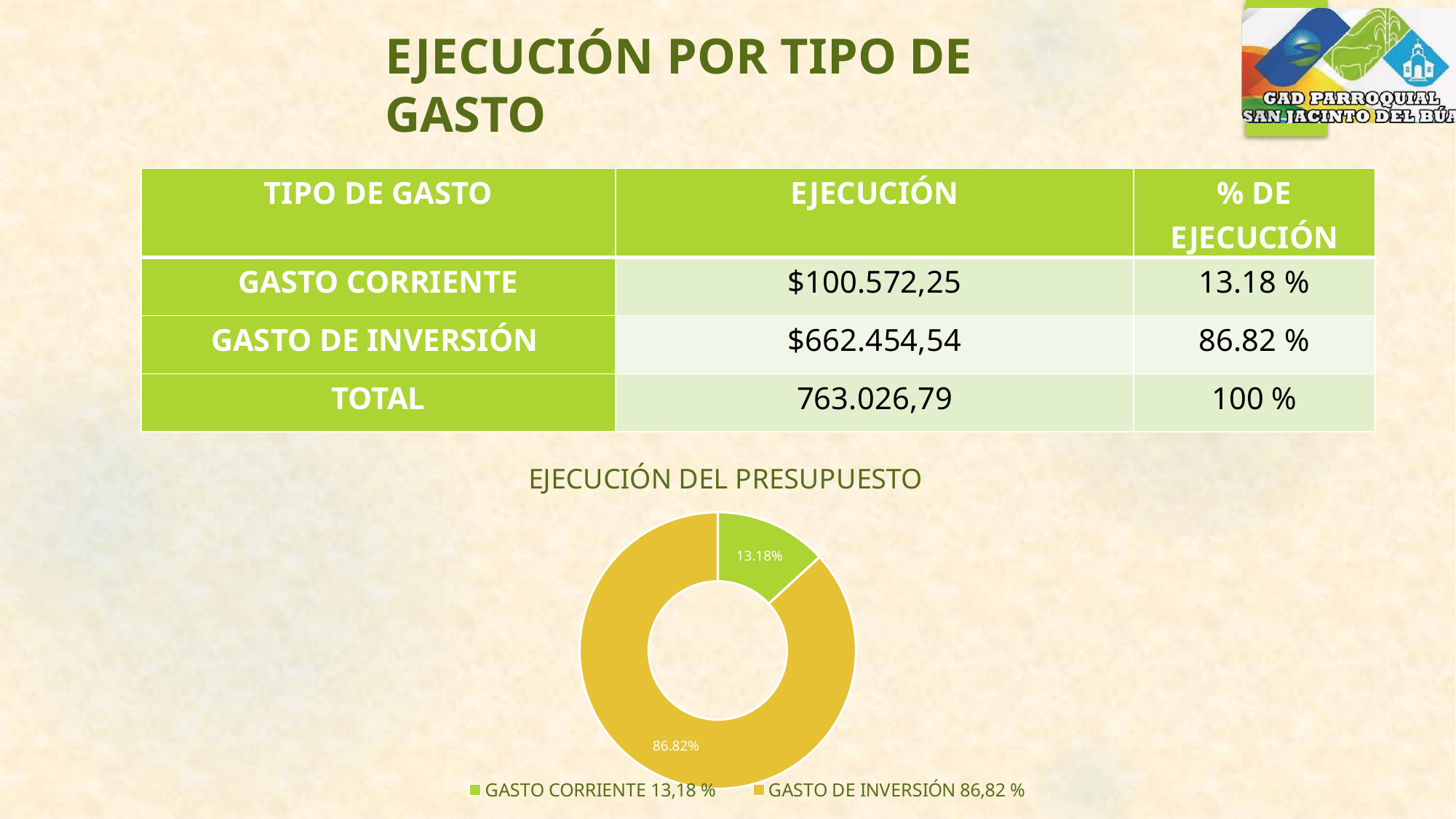
What colour is the GASTO DE INVERSIÓN slice in the chart? Gold/yellow What is the title of the chart on the slide? EJECUCIÓN DEL PRESUPUESTO How many entries does the chart legend list? 2 Which slice of the chart is the smallest? GASTO CORRIENTE Which slice of the chart is the largest? GASTO DE INVERSIÓN What percentage does the chart show for GASTO DE INVERSIÓN? 86.82% Which is larger in the chart, GASTO CORRIENTE or GASTO DE INVERSIÓN? GASTO DE INVERSIÓN What share of the doughnut chart does GASTO CORRIENTE represent? 13.18% What type of chart is shown under the title "EJECUCIÓN DEL PRESUPUESTO"? Doughnut chart What percentage does the chart show for GASTO CORRIENTE? 13.18% How many slices does the doughnut chart have? 2 What is the difference in percentage points between the GASTO DE INVERSIÓN slice and the GASTO CORRIENTE slice? 73.64